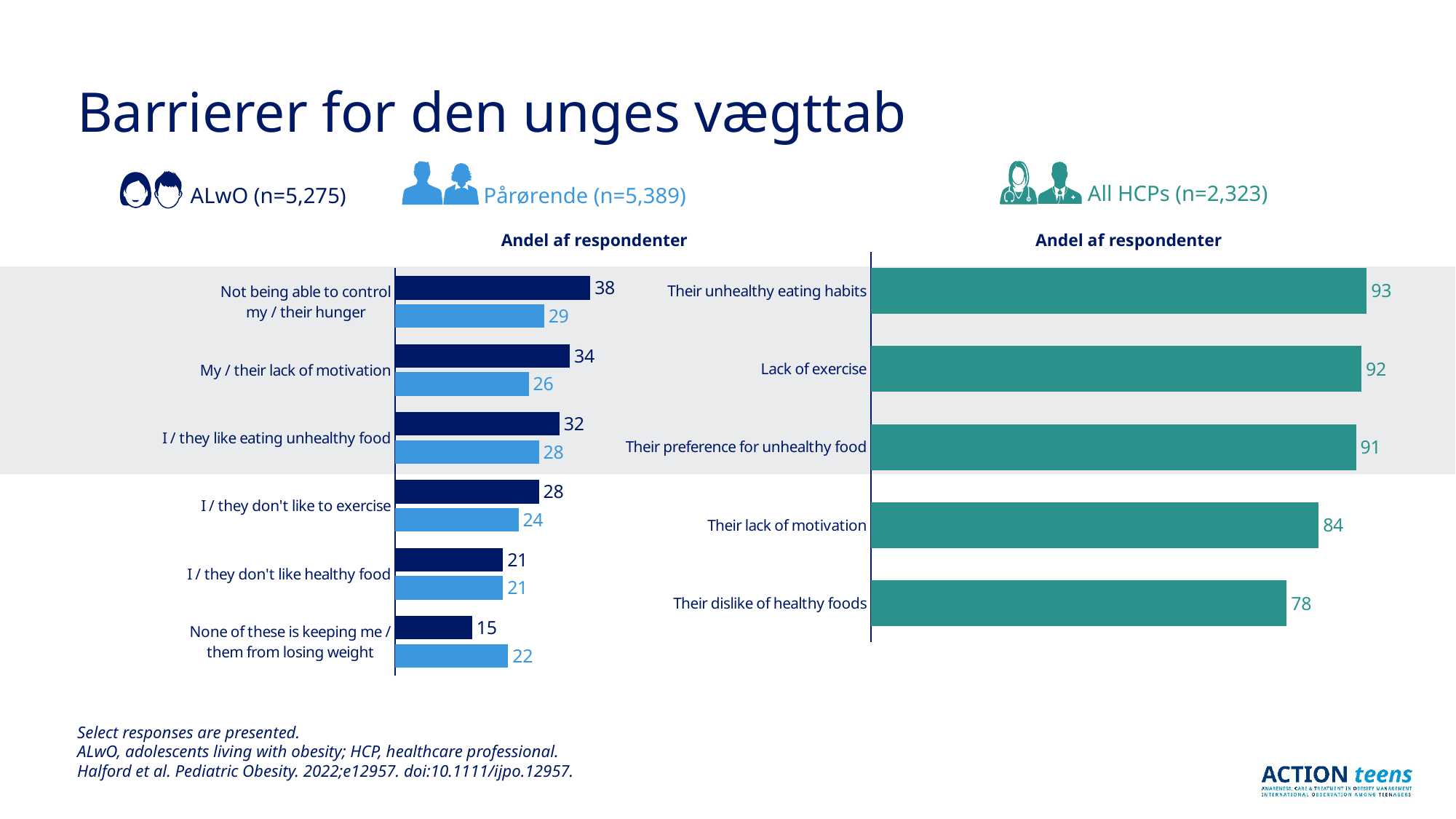
In the right chart (All HCPs), what is the value for "Their lack of motivation"? 84 In the left chart (ALwO and Pårørende), for "None of these is keeping me / them from losing weight", which is larger: the ALwO value or the Pårørende value? Pårørende In the left chart (ALwO and Pårørende), what is the difference between the ALwO and Pårørende values for "Not being able to control my / their hunger"? 9 In the right chart (All HCPs), which barrier has the highest value? Their unhealthy eating habits In the left chart (ALwO and Pårørende), what is the ALwO value for "Not being able to control my / their hunger"? 38 In the right chart (All HCPs), which barrier has the lowest value? Their dislike of healthy foods How many barriers are listed in the right chart (All HCPs)? 5 In the right chart (All HCPs), what is the difference between "Their unhealthy eating habits" and "Their dislike of healthy foods"? 15 How many series are shown in the left chart (ALwO and Pårørende)? 2 In the left chart (ALwO and Pårørende), which barrier has the lowest ALwO value? None of these is keeping me / them from losing weight In the left chart (ALwO and Pårørende), what is the Pårørende value for "My / their lack of motivation"? 26 What type of chart is the right chart (All HCPs)? Bar chart